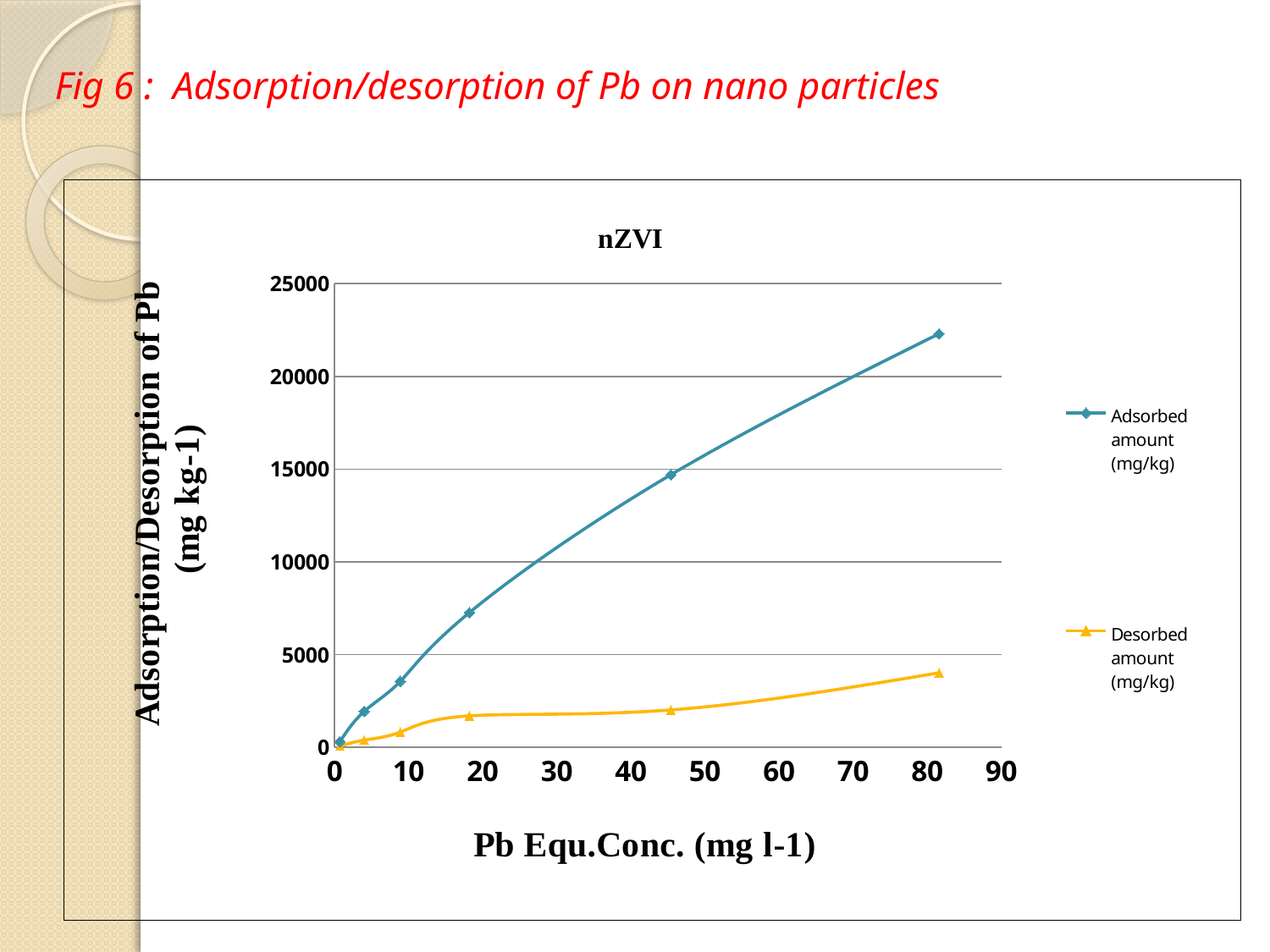
What is the label of the x axis? Pb Equ.Conc. (mg l-1) What is the title of the chart? nZVI Is the highest value of the Desorbed amount (mg/kg) series greater or less than 5000? less How many series does the legend list? 2 At the highest Pb equilibrium concentration plotted, which series has the larger value, Adsorbed amount or Desorbed amount? Adsorbed amount (mg/kg) Does the Adsorbed amount (mg/kg) series rise or fall as Pb equilibrium concentration increases? rise How many data points are plotted for the Adsorbed amount (mg/kg) series? 6 Is the Adsorbed amount (mg/kg) value at a Pb equilibrium concentration of about 45 mg l-1 greater or less than 10000? greater Does the Desorbed amount (mg/kg) series rise or fall along the x axis? rise Is the highest value of the Adsorbed amount (mg/kg) series greater or less than 20000? greater What kind of chart is shown on the slide? line chart Which series reaches the lowest maximum value on the chart? Desorbed amount (mg/kg)